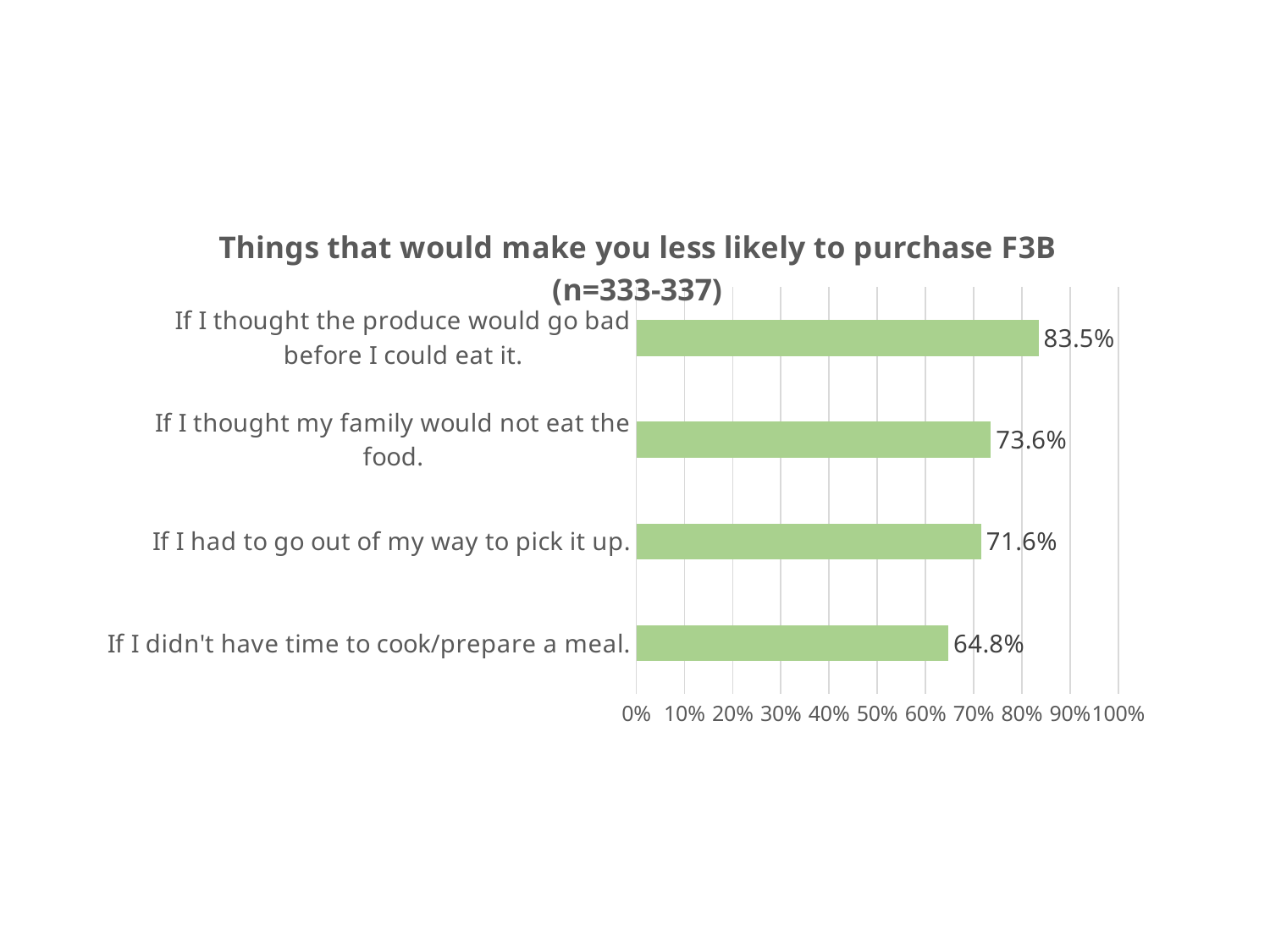
What kind of chart is shown on the slide? Bar chart What is the title of the chart? Things that would make you less likely to purchase F3B (n=333-337) What is the difference between the values for "If I thought the produce would go bad before I could eat it." and "If I didn't have time to cook/prepare a meal."? 18.7% Which is larger: the value for "If I thought my family would not eat the food." or the value for "If I didn't have time to cook/prepare a meal."? If I thought my family would not eat the food. Which category has the lowest value? If I didn't have time to cook/prepare a meal. What is the value for "If I had to go out of my way to pick it up."? 71.6% What percentage of respondents said they would be less likely to purchase F3B if they thought the produce would go bad before they could eat it? 83.5% Which category has the highest value? If I thought the produce would go bad before I could eat it. What is the value for "If I thought my family would not eat the food."? 73.6% What is the difference between the values for "If I thought my family would not eat the food." and "If I had to go out of my way to pick it up."? 2.0% How many categories are shown in the chart? 4 What is the value for "If I didn't have time to cook/prepare a meal."? 64.8%